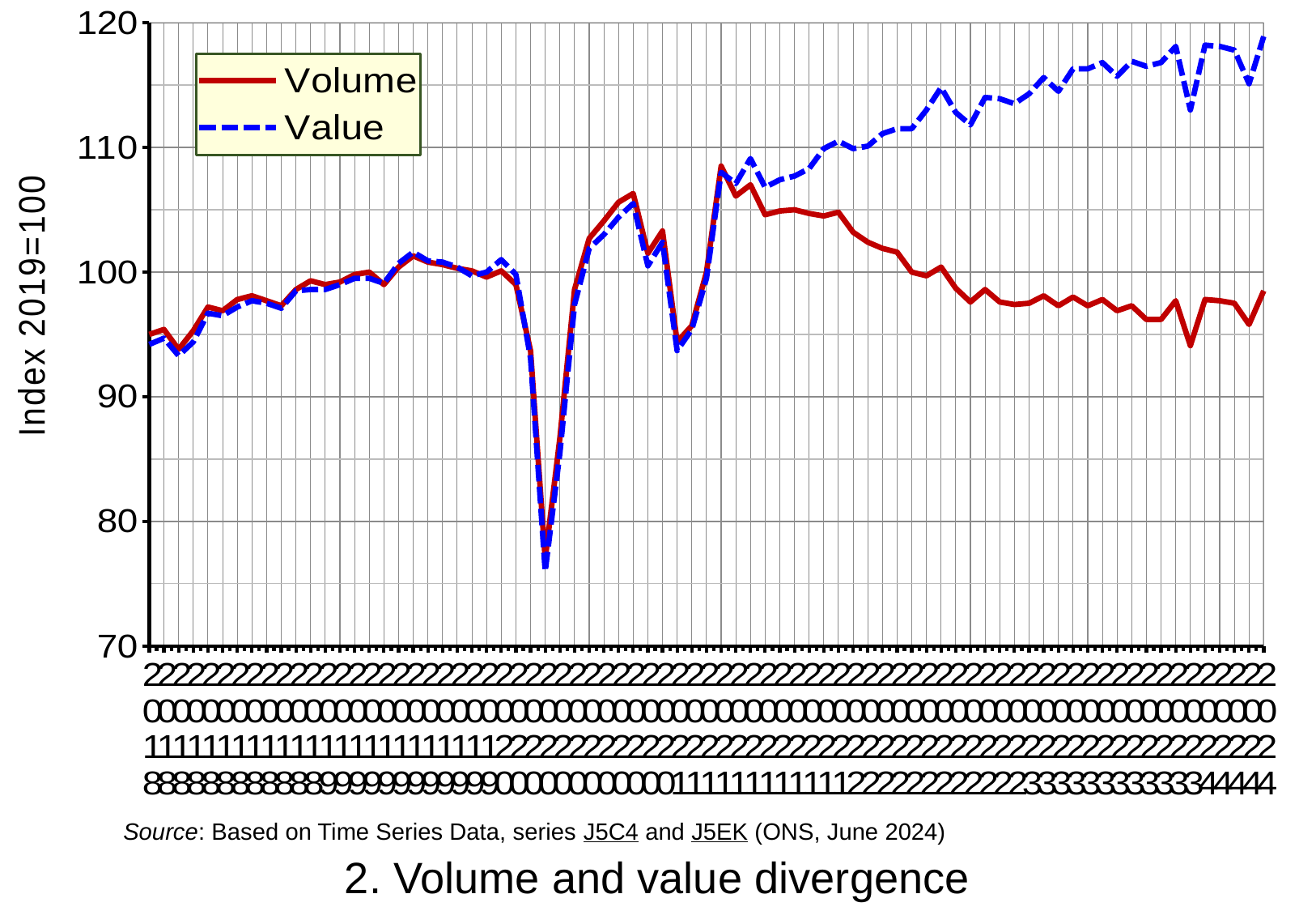
Over the right-hand third of the chart, does the Volume series generally rise or fall? fall Is the lowest point of the Value series greater or less than 80? less What is the title of the chart? 2. Volume and value divergence How many series does the legend list? 2 What kind of chart is shown on the slide? Line chart Is the highest point of the Value series greater or less than 110? greater Is the final value of the Volume series greater or less than 100? less Over the right-hand third of the chart, does the Value series generally rise or fall? rise At the right-hand end of the chart, which series is higher, Volume or Value? Value What is the label on the vertical axis? Index 2019=100